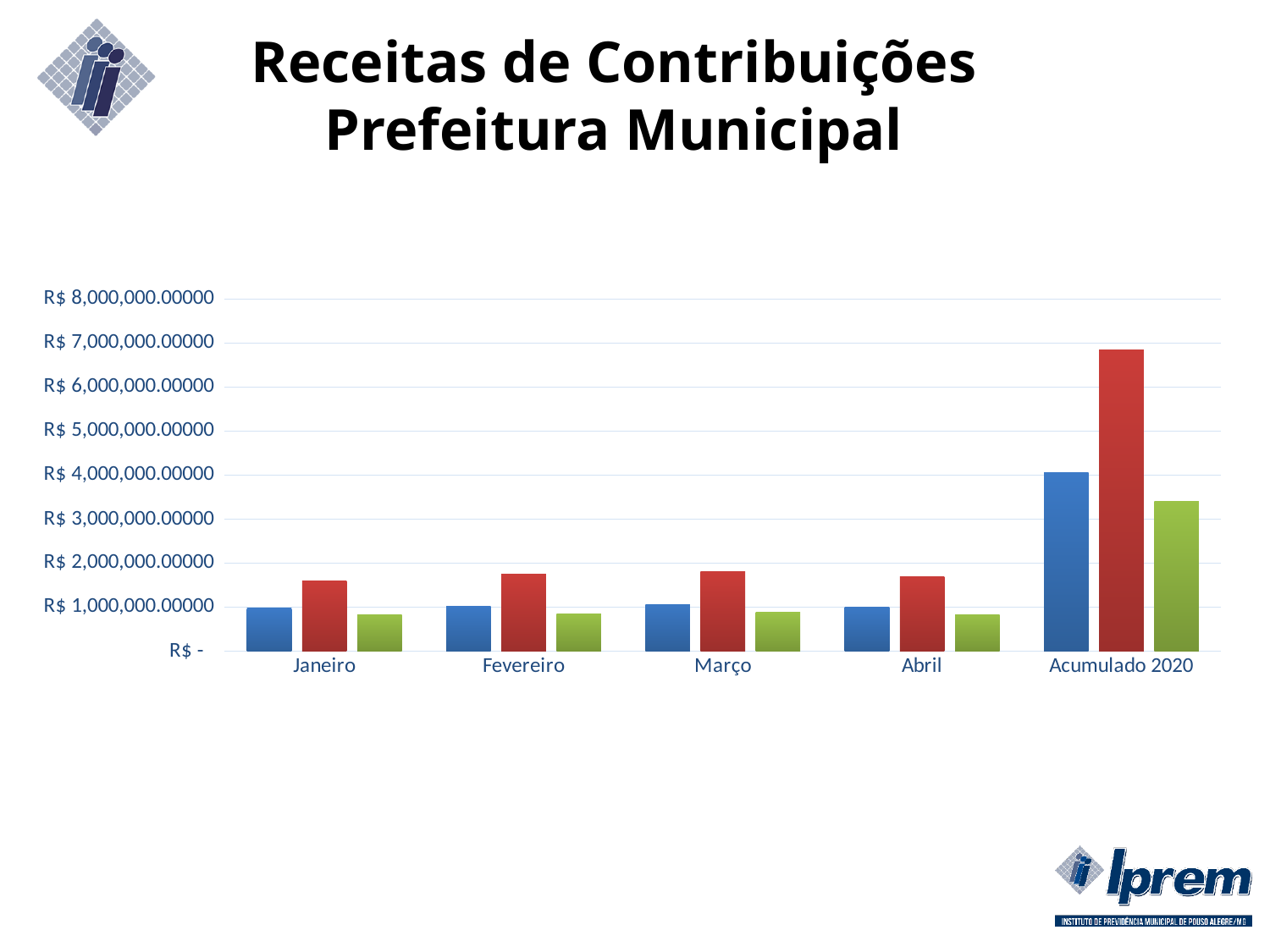
Is the value of the red bar for Acumulado 2020 greater or less than R$ 6,000,000.00000? greater Is the value of the red bar for Março greater or less than R$ 2,000,000.00000? less Which category on the x axis has the tallest bar in the chart? Acumulado 2020 Is the value of the green bar for Acumulado 2020 greater or less than R$ 3,000,000.00000? greater For Acumulado 2020, which bar is larger, the red bar or the blue bar? the red bar How many categories are shown along the x axis of the chart? 5 What kind of chart is shown on the slide? bar chart For Fevereiro, which bar is larger, the red bar or the green bar? the red bar What is the title shown above the chart on the slide? Receitas de Contribuições Prefeitura Municipal